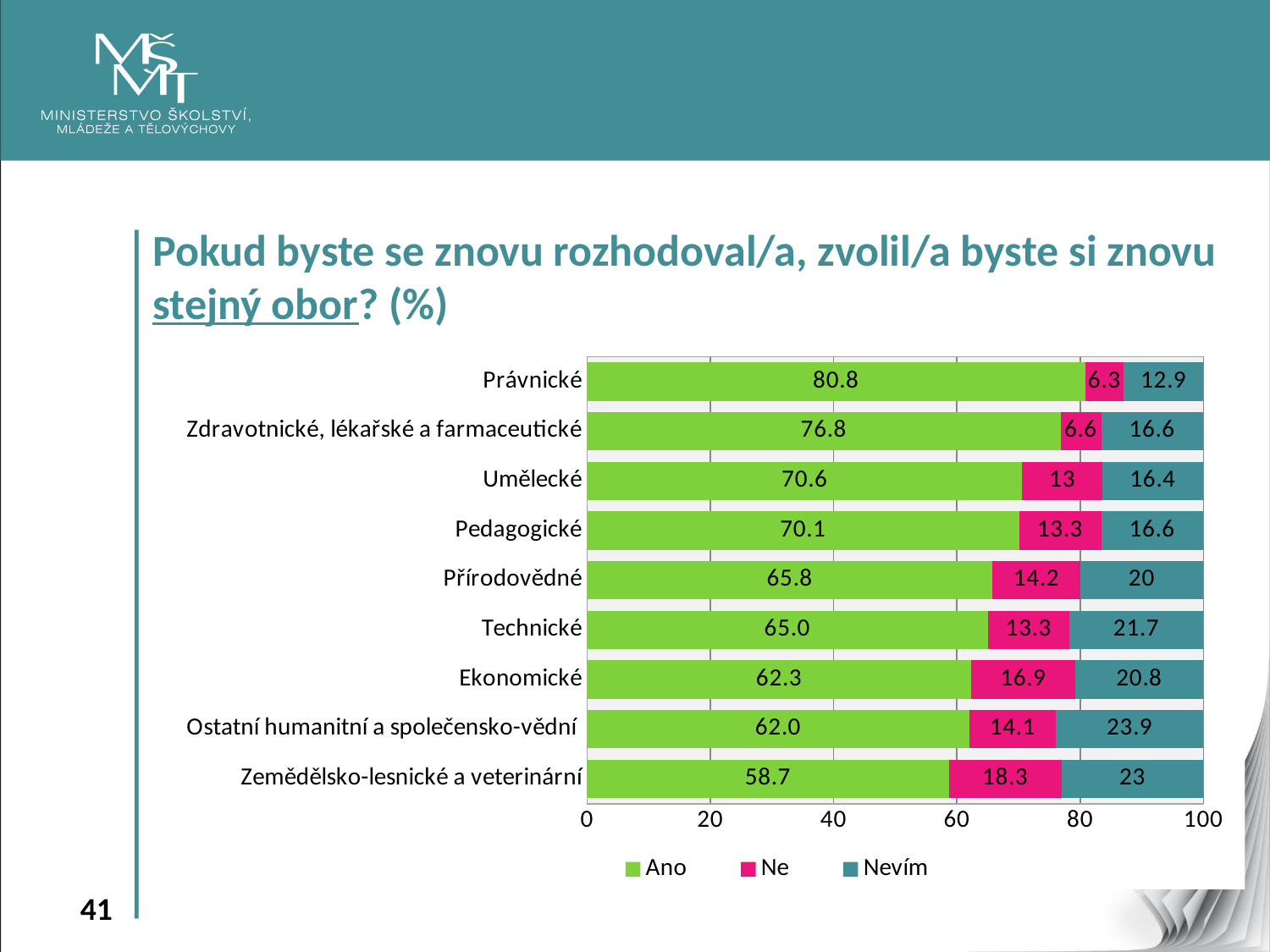
What is the total of the stacked bar for Přírodovědné? 100 What is the "Ne" value for Zemědělsko-lesnické a veterinární? 18.3 What is the "Ano" value for Právnické? 80.8 Which category has the highest "Ano" value? Právnické What is the difference between the "Ano" values for Právnické and Zemědělsko-lesnické a veterinární? 22.1 What kind of chart is shown on the slide? Stacked bar chart Which category has the lowest "Ne" value? Právnické How many series does the legend list? 3 Which is larger, the "Nevím" value for Ekonomické or for Ostatní humanitní a společensko-vědní? Ostatní humanitní a společensko-vědní What is the "Nevím" value for Technické? 21.7 Which category has the lowest "Ano" value? Zemědělsko-lesnické a veterinární How many categories are shown on the chart? 9